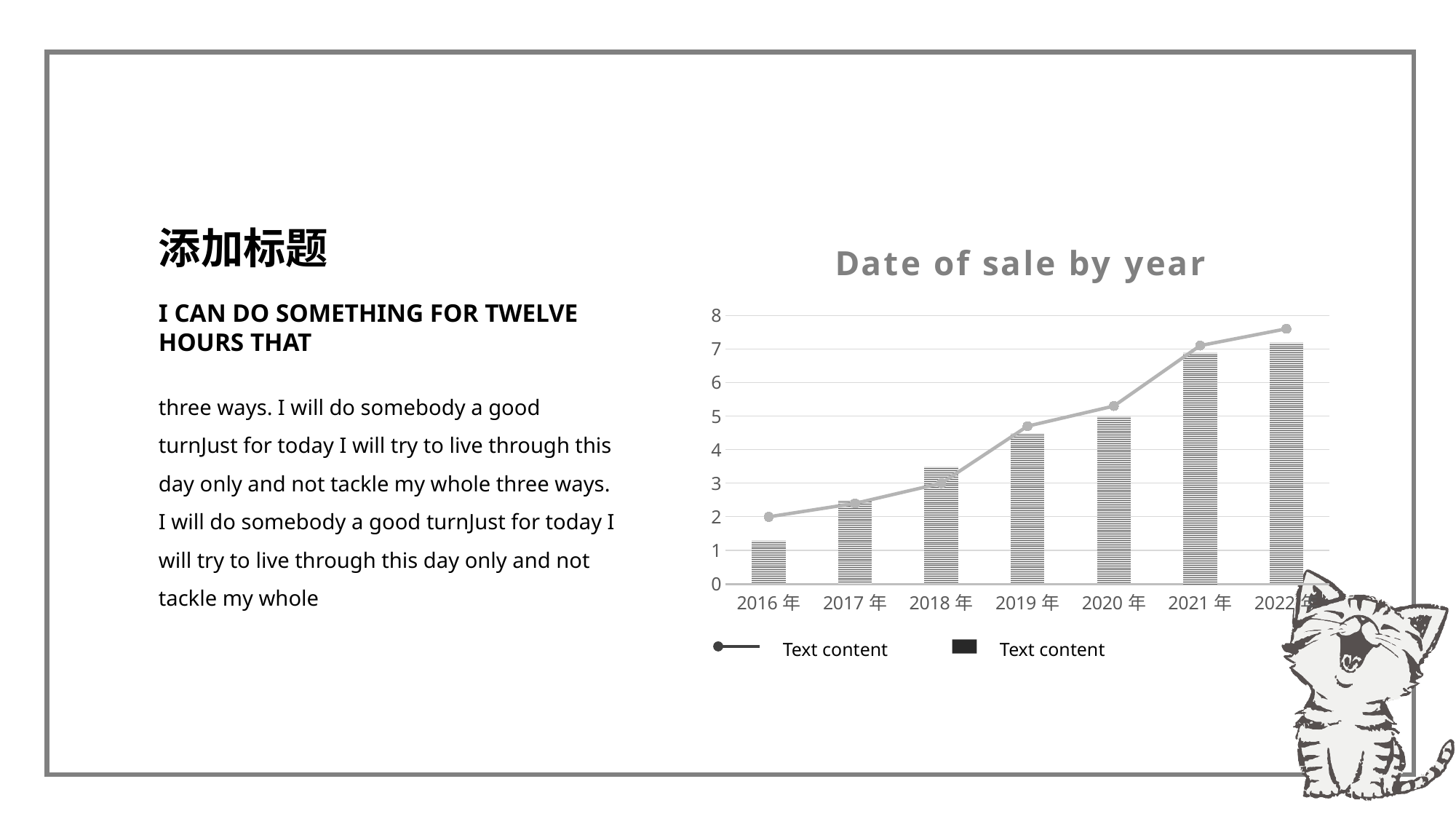
Is the bar value for 2016 年 greater or less than 2? less What kind of chart is shown on the slide? A combined bar and line chart Is the line value for 2022 年 greater or less than 7? greater How many series does the chart's legend list? 2 Which year has the shortest bar in the chart? 2016 年 Which year has the larger bar value, 2017 年 or 2019 年? 2019 年 Is the line value for 2019 年 greater or less than 4? greater Which year has the tallest bar in the chart? 2022 年 Do the bar values rise or fall from 2016 年 to 2022 年? rise How many years are shown on the x axis of the chart? 7 What is the title of the chart? Date of sale by year